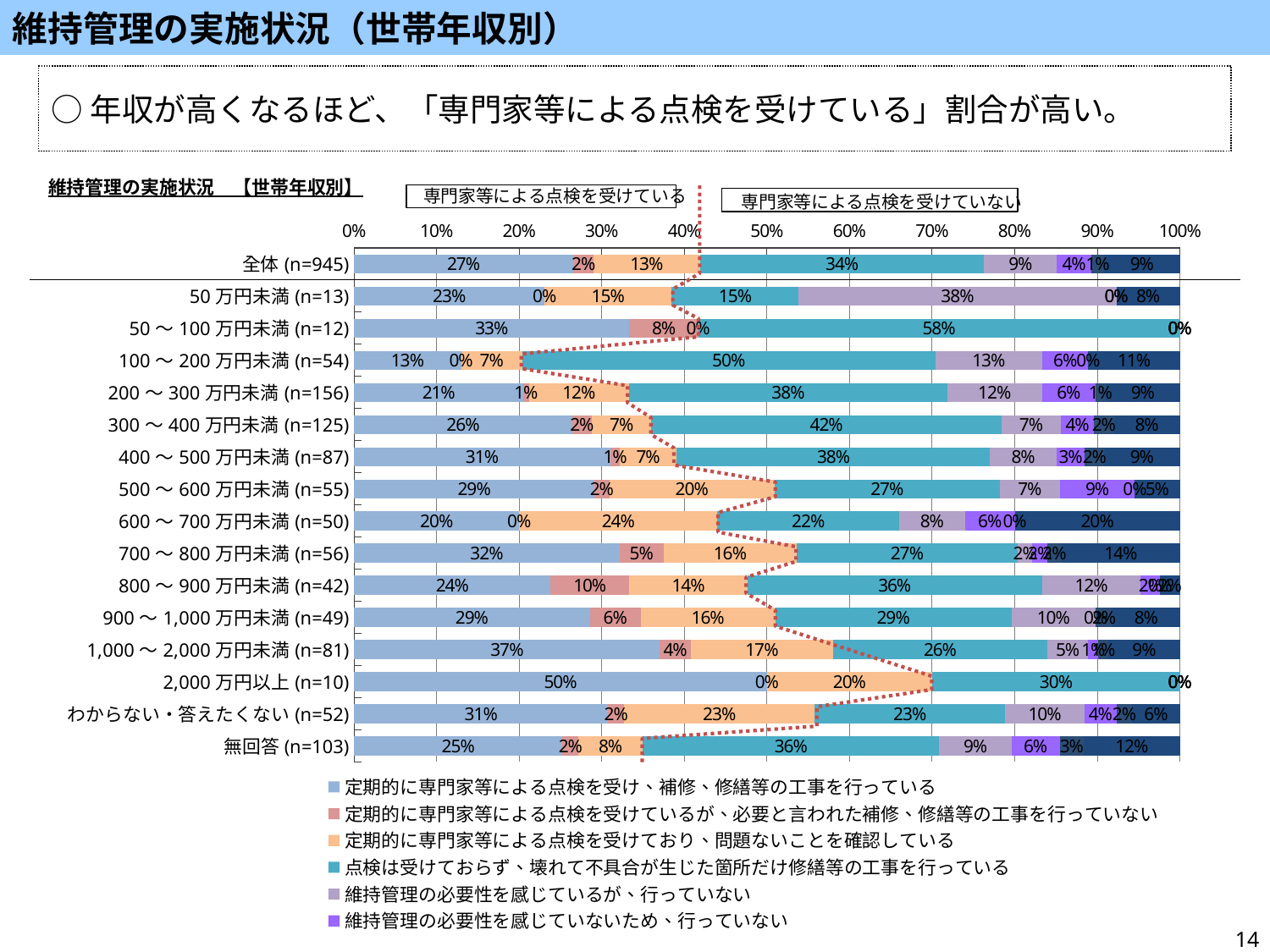
What is the value of 「定期的に専門家等による点検を受け、補修、修繕等の工事を行っている」 for 全体 (n=945)? 27% How many series does the legend below the chart list? 6 What is the value of 「点検は受けておらず、壊れて不具合が生じた箇所だけ修繕等の工事を行っている」 for 50～100万円未満 (n=12)? 58% Which income group has the lowest share of 「定期的に専門家等による点検を受け、補修、修繕等の工事を行っている」? 100～200万円未満 (n=54) What is the value of 「定期的に専門家等による点検を受けており、問題ないことを確認している」 for 600～700万円未満 (n=50)? 24% What is the sample size (n) for the 全体 row? 945 How many category rows (income groups including 全体) are plotted in the chart? 16 What is the value of 「定期的に専門家等による点検を受け、補修、修繕等の工事を行っている」 for 2,000万円以上 (n=10)? 50% Which has the larger share of 「点検は受けておらず、壊れて不具合が生じた箇所だけ修繕等の工事を行っている」: 50～100万円未満 or 2,000万円以上? 50～100万円未満 Which income group has the highest share of 「定期的に専門家等による点検を受け、補修、修繕等の工事を行っている」? 2,000万円以上 (n=10) What is the difference in percentage points between the 「定期的に専門家等による点検を受け、補修、修繕等の工事を行っている」 share for 2,000万円以上 and for 100～200万円未満? 37 percentage points What kind of chart is shown on the slide? Stacked bar chart